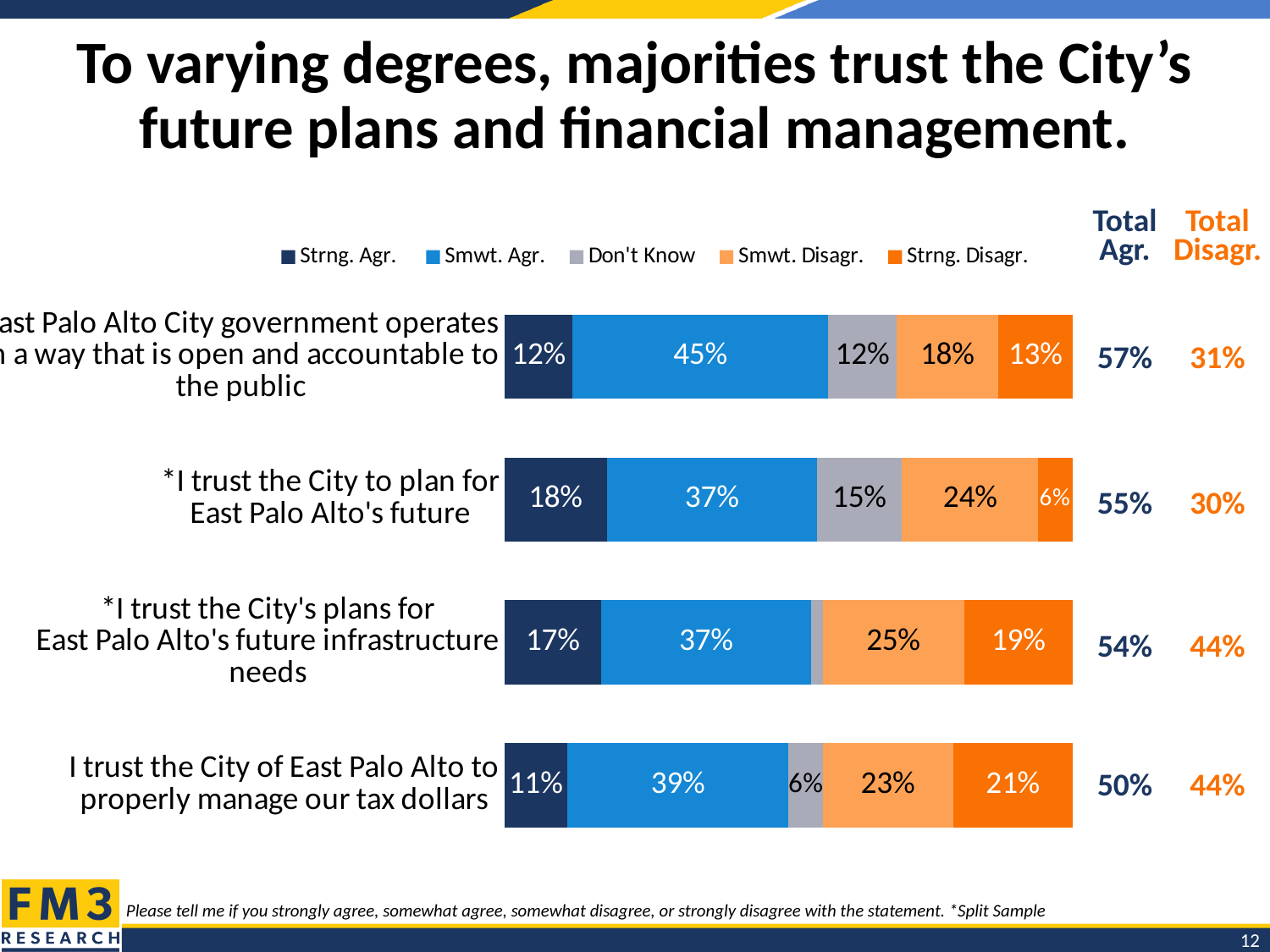
Which is larger: the Smwt. Disagr. value for "I trust the City to plan for East Palo Alto's future" or the Smwt. Disagr. value for "I trust the City of East Palo Alto to properly manage our tax dollars"? I trust the City to plan for East Palo Alto's future (24%) What percentage strongly agree that the City government operates in a way that is open and accountable to the public? 12% What percentage somewhat agree with the statement "I trust the City to plan for East Palo Alto's future"? 37% What is the difference between the Total Agr. and Total Disagr. values for "I trust the City's plans for East Palo Alto's future infrastructure needs"? 10% Which statement has the highest Total Agr. value? East Palo Alto City government operates in a way that is open and accountable to the public Which legend entry is shown in grey? Don't Know What kind of chart is shown on the slide? Stacked bar chart What is the Strng. Disagr. value for "I trust the City of East Palo Alto to properly manage our tax dollars"? 21% What is the Don't Know value for "I trust the City to plan for East Palo Alto's future"? 15% How many statements (categories) are plotted in the chart? 4 How many series does the legend list? 5 Which statement has the lowest Total Agr. value? I trust the City of East Palo Alto to properly manage our tax dollars